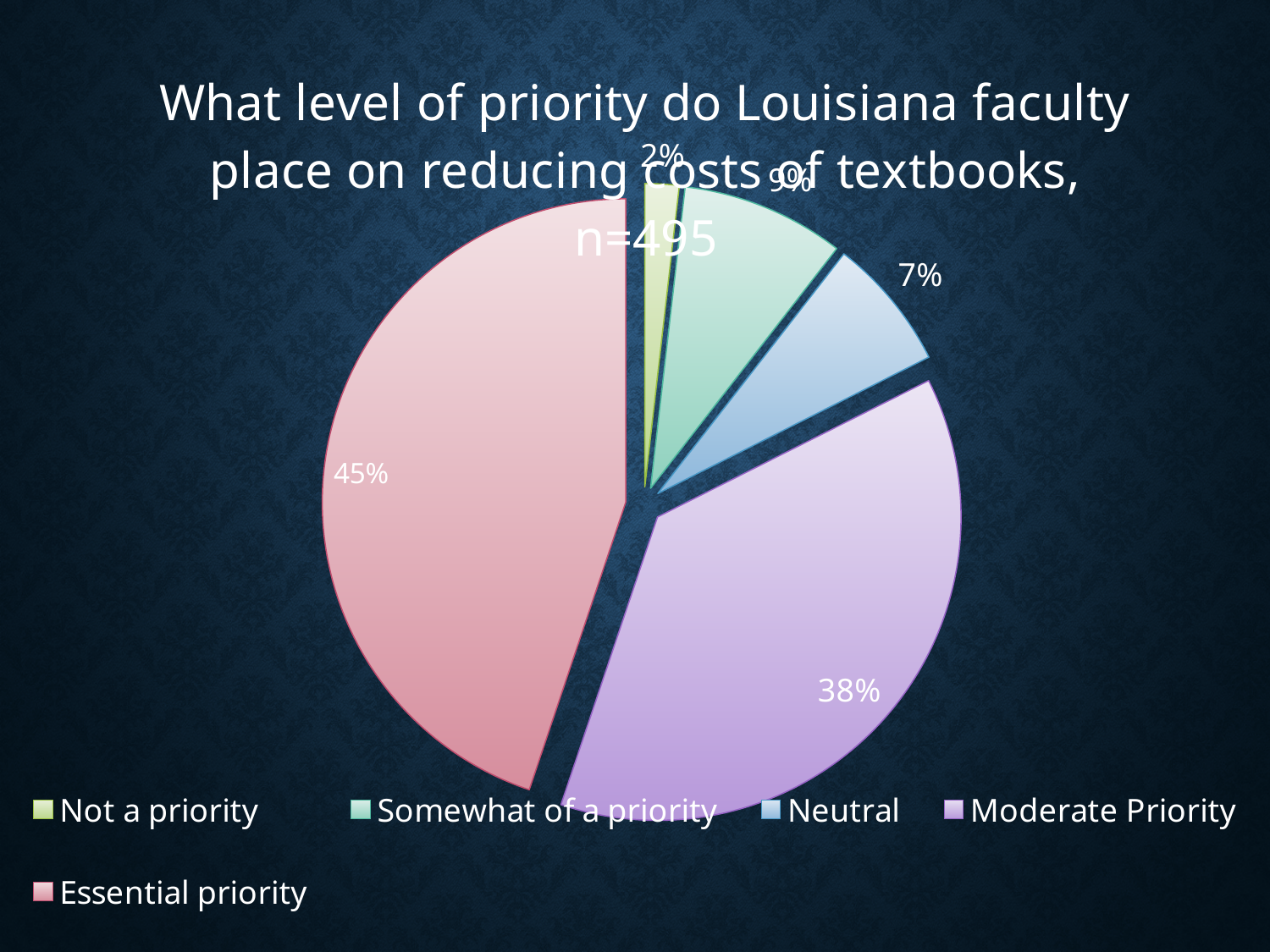
Which is larger, Moderate Priority or Essential priority? Essential priority Which category has the smallest slice of the pie? Not a priority According to the chart title, how many faculty responded (n)? 495 What share of the pie is labelled Neutral? 7% What type of chart is shown on the slide? Pie chart What percentage of faculty said reducing textbook costs is Not a priority? 2% What percentage of respondents chose Moderate Priority? 38% How many categories does the pie chart show? 5 How many percentage points larger is the Essential priority slice than the Moderate Priority slice? 7 What percentage of Louisiana faculty rated reducing textbook costs as an Essential priority? 45% Which slice is larger, Neutral or Not a priority? Neutral Which category has the largest slice of the pie? Essential priority